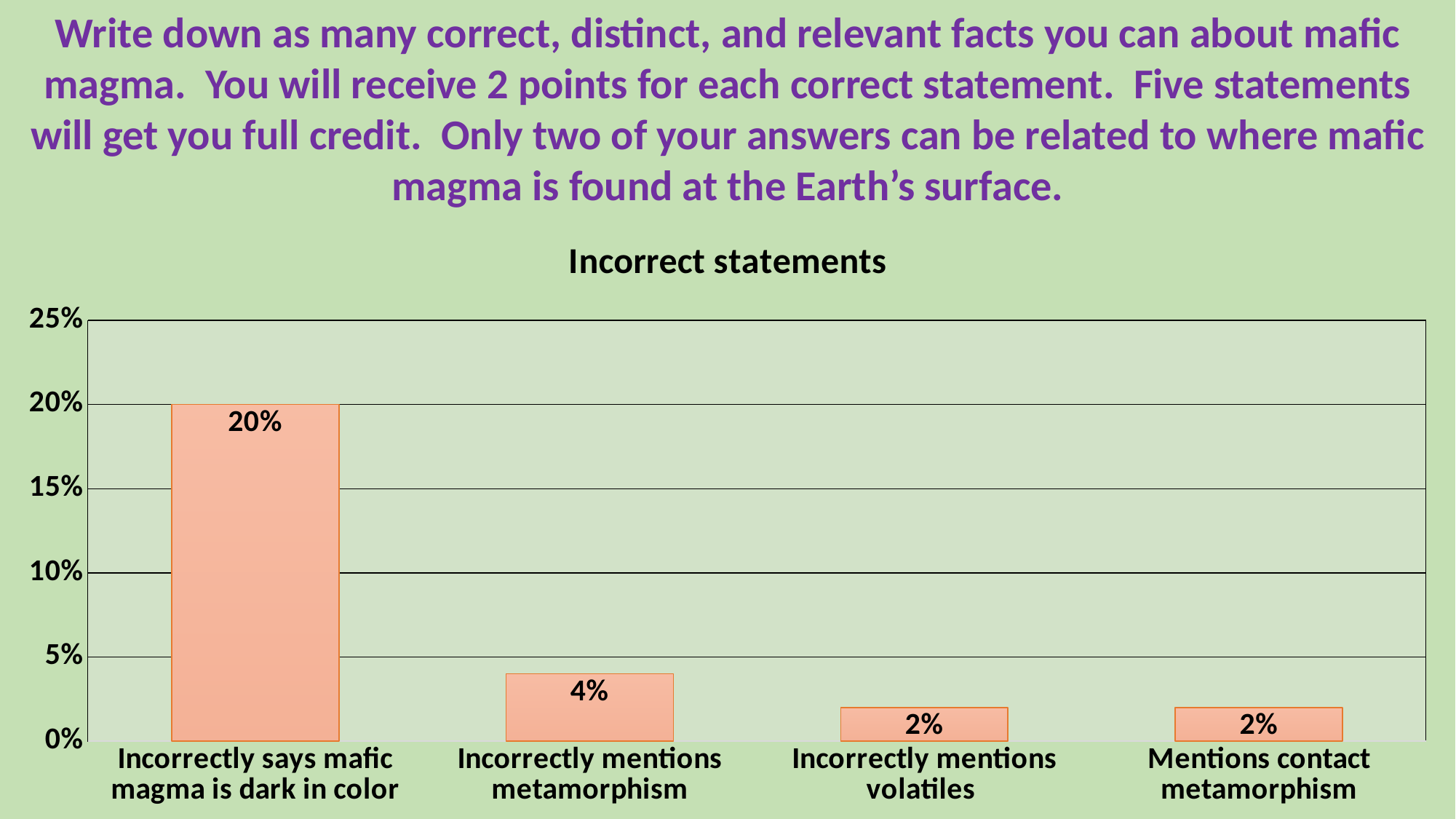
What is the value for "Mentions contact metamorphism"? 2% Which category has the highest value? Incorrectly says mafic magma is dark in color What kind of chart is shown on the slide? bar chart What is the difference between the values for "Incorrectly says mafic magma is dark in color" and "Incorrectly mentions metamorphism"? 16% Is the value for "Incorrectly says mafic magma is dark in color" greater or less than 15%? greater What is the value for "Incorrectly mentions metamorphism"? 4% Which is larger, the value for "Incorrectly mentions metamorphism" or the value for "Incorrectly mentions volatiles"? Incorrectly mentions metamorphism What is the value for "Incorrectly mentions volatiles"? 2% What is the value for "Incorrectly says mafic magma is dark in color"? 20% How many categories are shown in the chart? 4 Is the value for "Incorrectly mentions metamorphism" greater or less than 5%? less What is the title of the chart? Incorrect statements